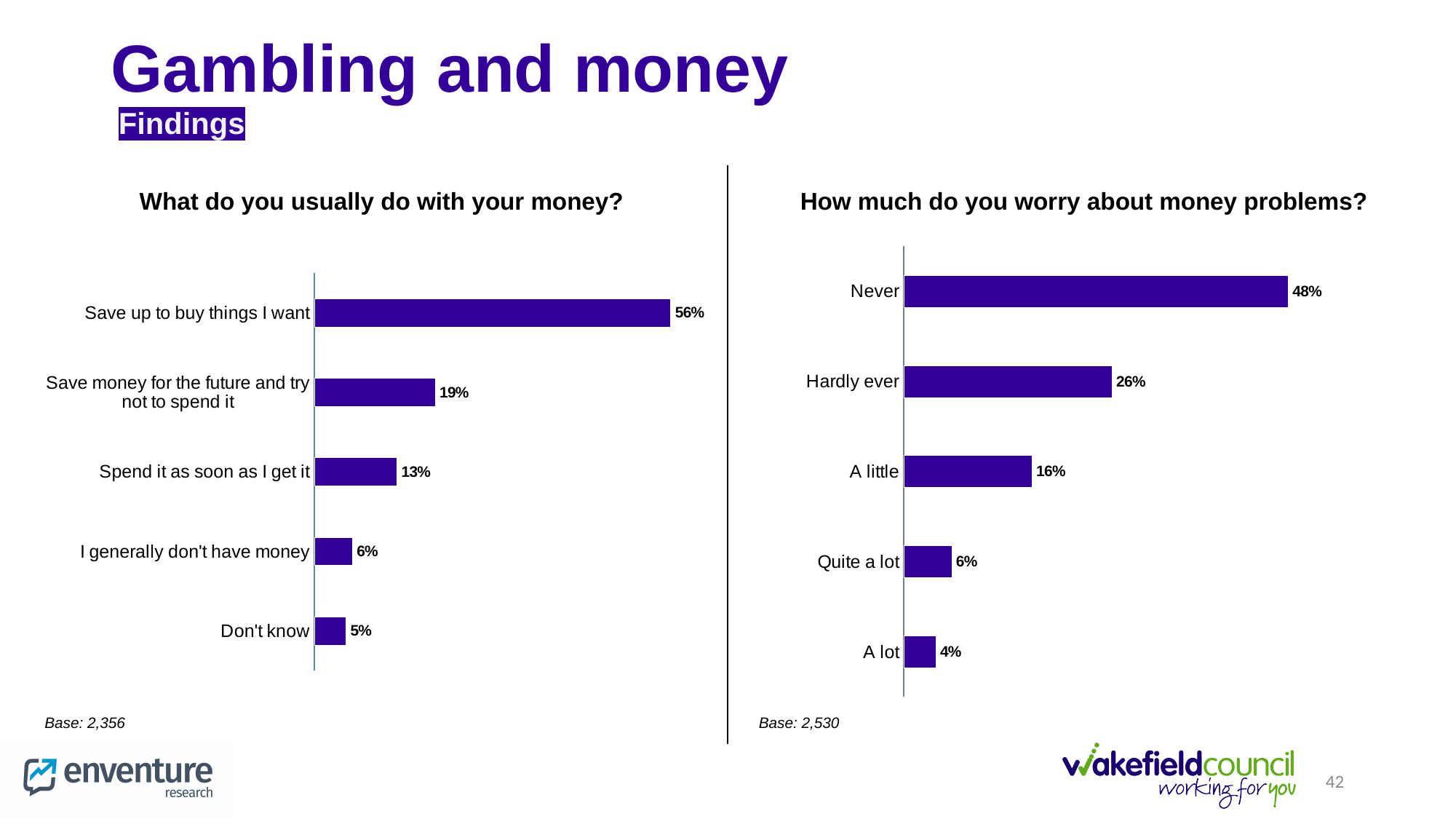
In the 'How much do you worry about money problems?' chart, which is larger: 'Hardly ever' or 'A little'? Hardly ever In the 'What do you usually do with your money?' chart, what is the difference between 'Save up to buy things I want' and 'Save money for the future and try not to spend it'? 37% In the 'How much do you worry about money problems?' chart, what percentage is shown for 'Quite a lot'? 6% What is the base (number of respondents) shown under the 'What do you usually do with your money?' chart? 2,356 What type of chart is the 'How much do you worry about money problems?' chart? Bar chart In the 'What do you usually do with your money?' chart, what percentage is shown for 'Save up to buy things I want'? 56% In the 'What do you usually do with your money?' chart, which category has the lowest value? Don't know In the 'How much do you worry about money problems?' chart, which category has the highest value? Never In the 'How much do you worry about money problems?' chart, what is the difference between 'A little' and 'A lot'? 12% In the 'What do you usually do with your money?' chart, what percentage is shown for 'Spend it as soon as I get it'? 13% In the 'How much do you worry about money problems?' chart, what percentage is shown for 'Never'? 48% In the 'What do you usually do with your money?' chart, how many categories are shown? 5